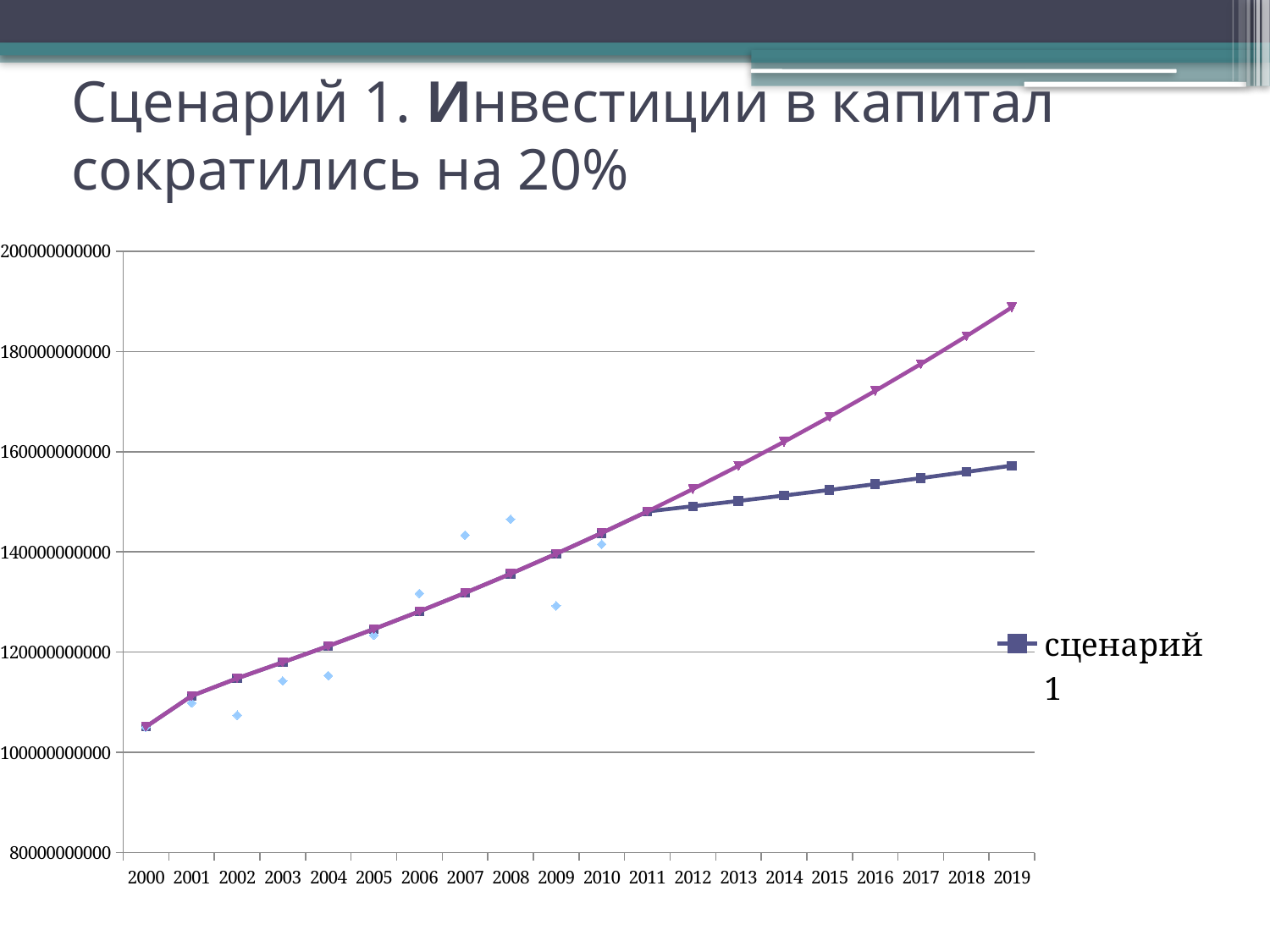
What kind of chart is shown on the slide? line chart What is the name of the series listed in the chart legend? сценарий 1 Does the 'сценарий 1' line rise or fall from 2000 to 2019? rises How many series does the chart legend list? 1 Is the value of 'сценарий 1' in 2019 greater or less than 160000000000? less How many years are shown on the x axis of the chart? 20 Is the value of 'сценарий 1' in 2000 greater or less than 100000000000? greater In which year does the 'сценарий 1' line have its lowest value? 2000 Is the value of the purple line with triangle markers in 2019 greater or less than 180000000000? greater In 2019, which is higher: the purple line with triangle markers or the 'сценарий 1' line? the purple line with triangle markers In which year does the 'сценарий 1' line reach its highest value? 2019